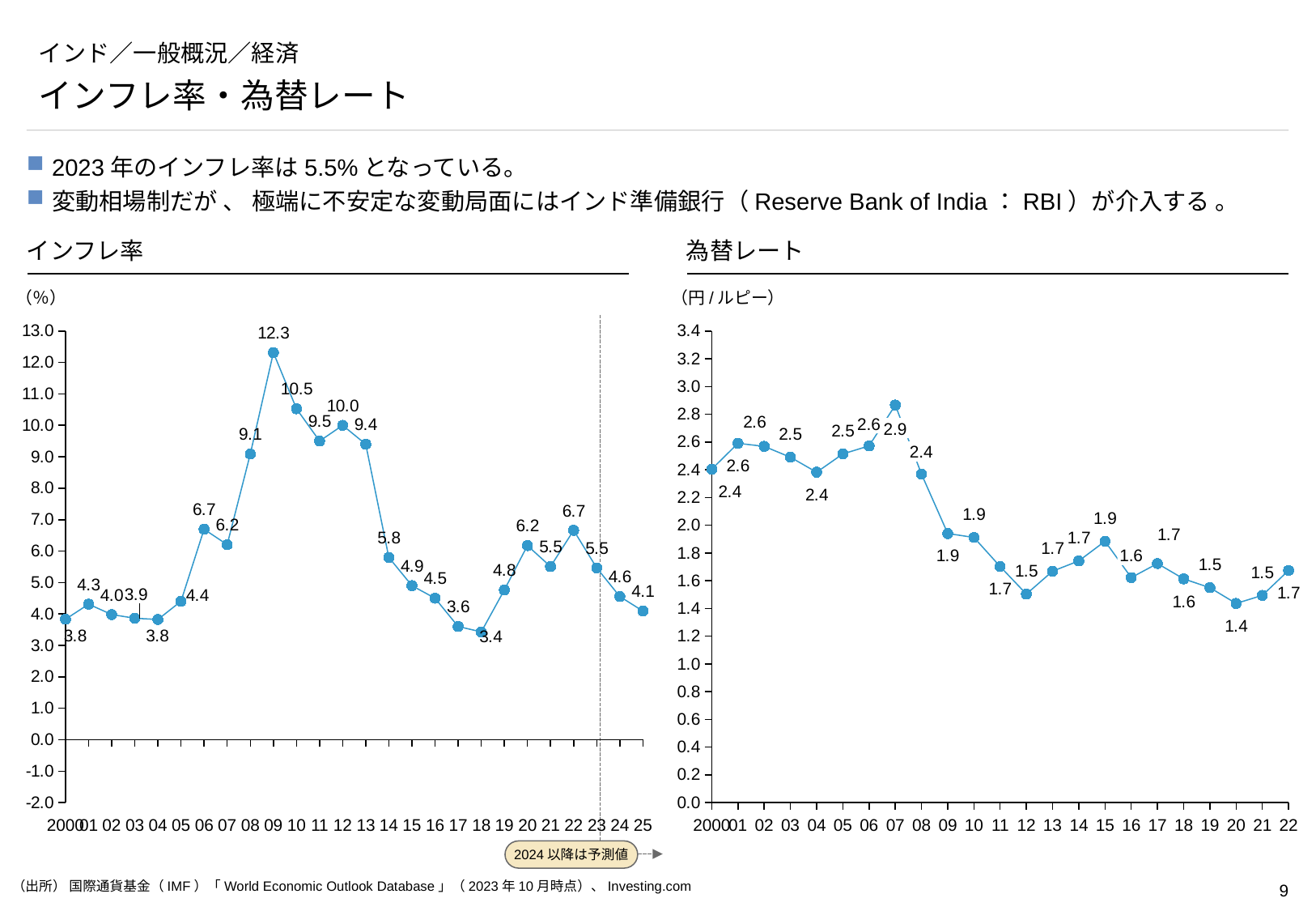
On the 為替レート chart, which year has the highest exchange rate? 2007 On the インフレ率 chart, which year has the highest inflation rate? 2009 On the インフレ率 chart, which is larger, the value for 2022 or the value for 2023? 2022 On the インフレ率 chart, what is the lowest inflation rate shown, and in which year? 3.4 in 2018 On the インフレ率 chart, what is the forecast inflation rate for 2025? 4.1 On the 為替レート chart, what is the lowest value shown, and in which year? 1.4 in 2020 On the 為替レート chart, what is the exchange rate for 2022? 1.7 What kind of chart is the インフレ率 chart? line chart On the インフレ率 chart, from which year onward are the values forecasts, according to the note? 2024 On the インフレ率 chart, what is the inflation rate for 2009? 12.3 On the 為替レート chart, does the exchange rate rise or fall from 2007 to 2012? fall On the インフレ率 chart, what is the difference between the 2009 value and the 2010 value? 1.8